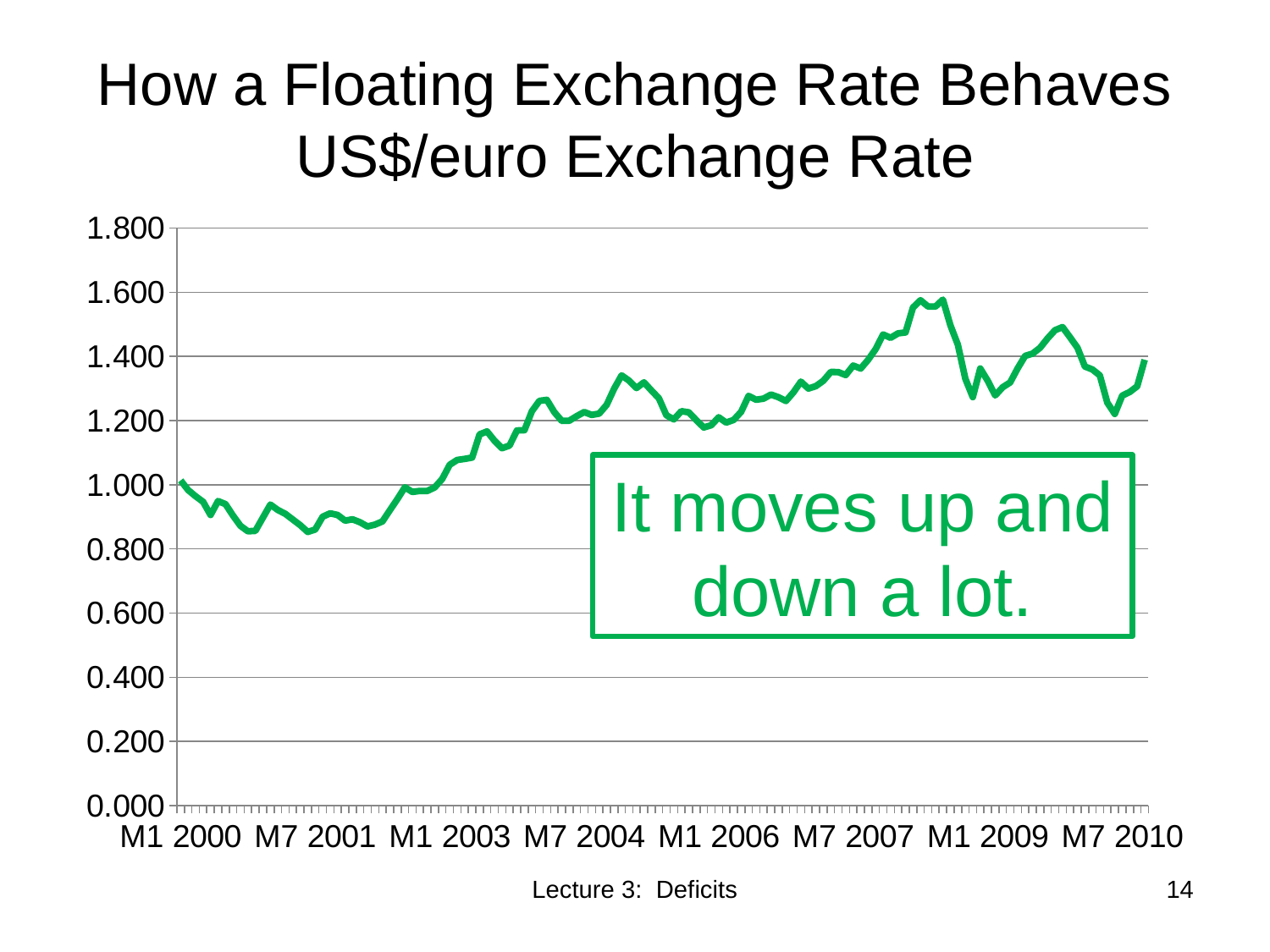
What is the highest value shown on the vertical axis? 1.800 Is the value for M7 2007 greater or less than 1.200? greater Does the exchange rate rise or fall between M7 2001 and M7 2004? rise Is the value for M7 2010 greater or less than 1.400? less Is the highest point of the line greater or less than 1.400? greater What does the green text box on the chart say? It moves up and down a lot. What kind of chart is shown on the slide? line chart Does the exchange rate rise or fall between M1 2000 and M7 2001? fall